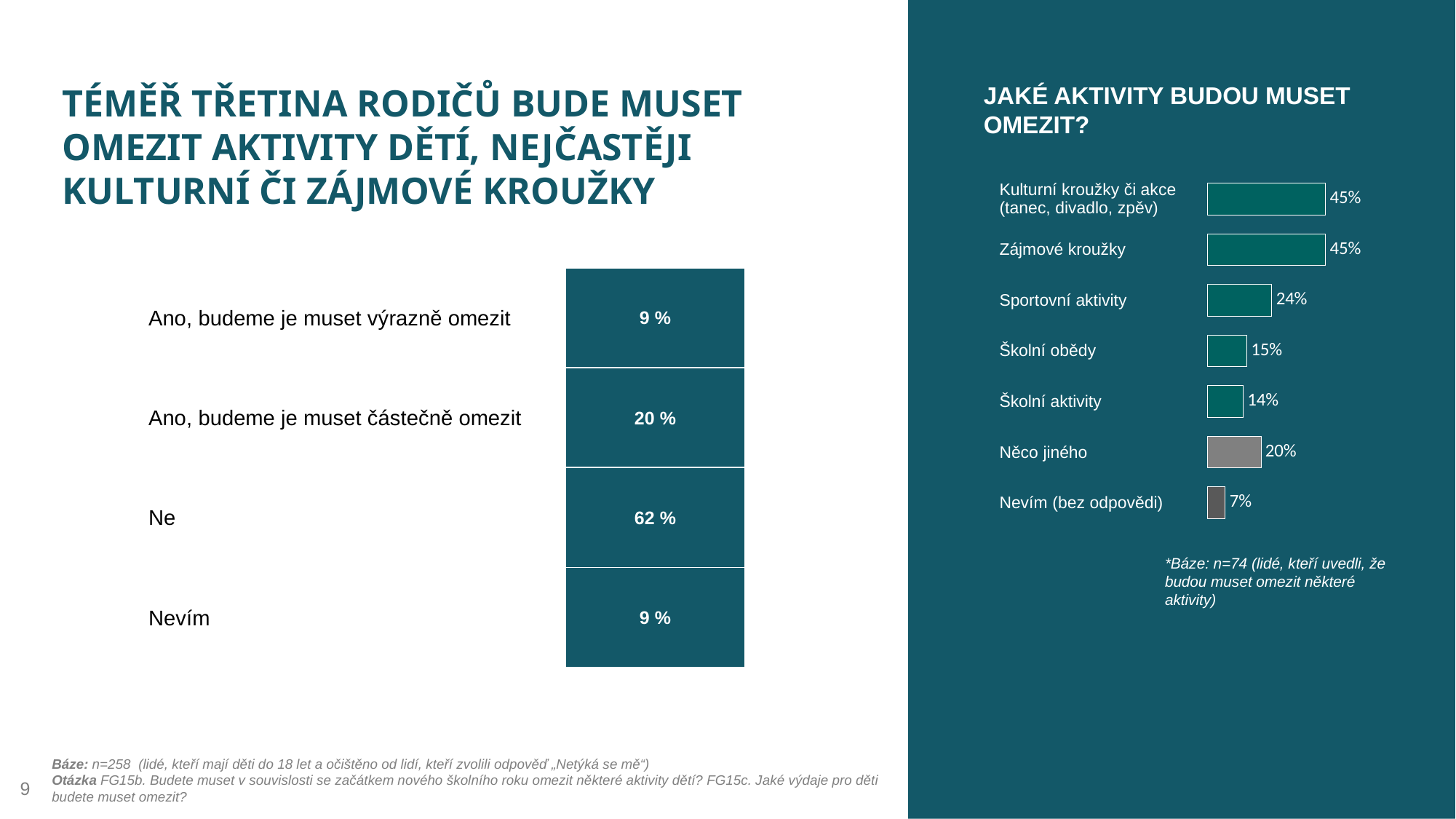
In the chart "JAKÉ AKTIVITY BUDOU MUSET OMEZIT?", what is the difference between "Zájmové kroužky" and "Sportovní aktivity"? 21% In the chart on the left, what is the value for "Ano, budeme je muset částečně omezit"? 20 % In the chart on the left, which category has the highest value? Ne In the chart "JAKÉ AKTIVITY BUDOU MUSET OMEZIT?", which category has the lowest value? Nevím (bez odpovědi) In the chart "JAKÉ AKTIVITY BUDOU MUSET OMEZIT?", what is the value for "Sportovní aktivity"? 24% In the chart "JAKÉ AKTIVITY BUDOU MUSET OMEZIT?", what is the value for "Školní obědy"? 15% In the chart on the left, how many categories are shown? 4 In the chart "JAKÉ AKTIVITY BUDOU MUSET OMEZIT?", which is larger: "Něco jiného" or "Školní aktivity"? Něco jiného In the chart on the left, what is the value for "Ne"? 62 % What kind of chart is "JAKÉ AKTIVITY BUDOU MUSET OMEZIT?"? Bar chart In the chart on the left, what is the total of all the stacked segments? 100 % In the chart on the left, what is the difference between the values for "Ne" and "Ano, budeme je muset částečně omezit"? 42 %